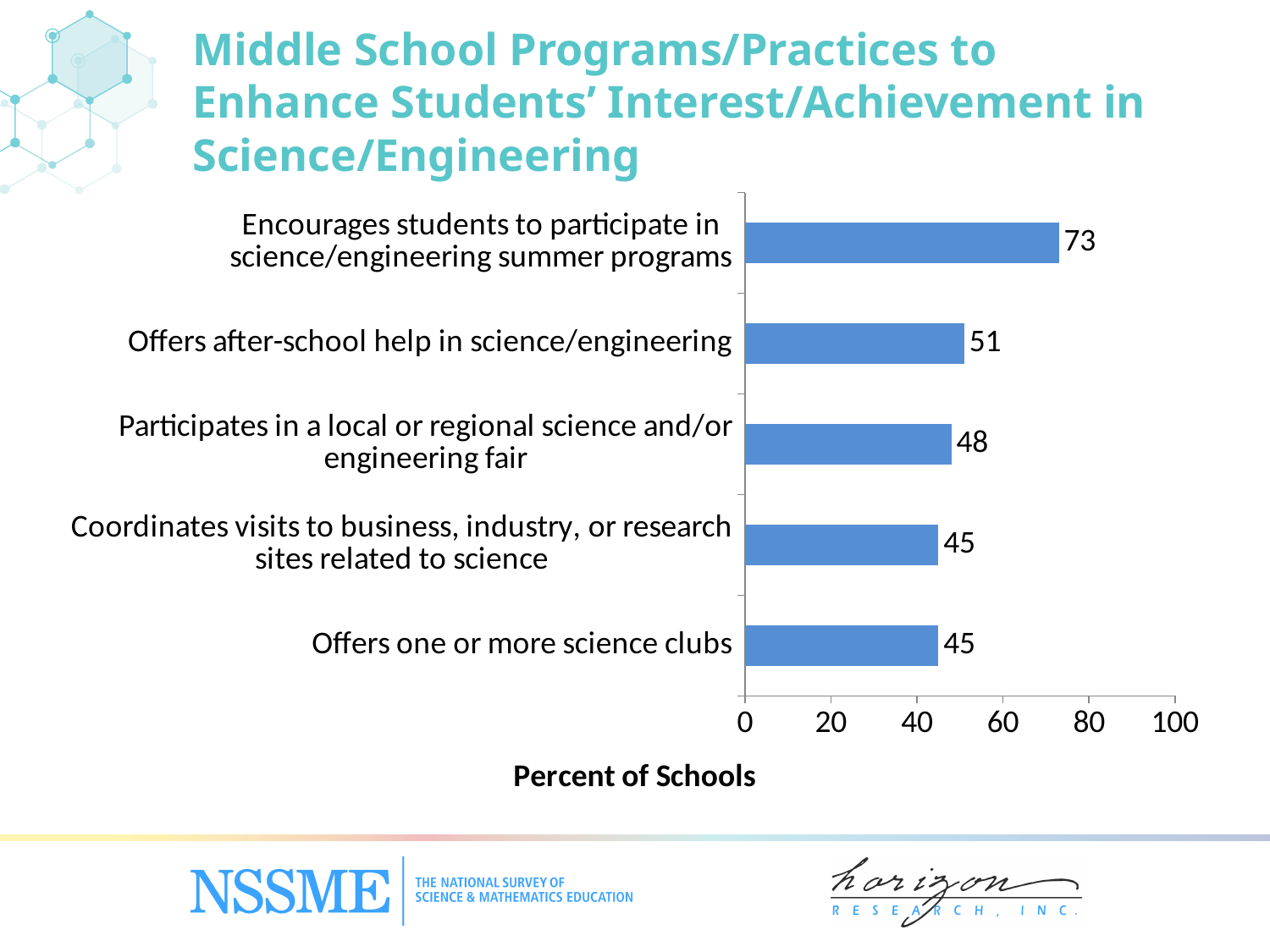
What percent of schools offer after-school help in science/engineering? 51 Which program/practice has the highest percent of schools? Encourages students to participate in science/engineering summer programs What percent of schools coordinate visits to business, industry, or research sites related to science? 45 Which has a higher percent of schools: offering after-school help in science/engineering or participating in a local or regional science and/or engineering fair? Offers after-school help in science/engineering Is the value for offering one or more science clubs greater or less than 60? less What percent of schools encourage students to participate in science/engineering summer programs? 73 What is the difference in percent of schools between encouraging participation in summer programs and offering after-school help in science/engineering? 22 What is the label of the horizontal axis? Percent of Schools What percent of schools participate in a local or regional science and/or engineering fair? 48 How many programs/practices are shown in the chart? 5 What kind of chart is shown on the slide? Bar chart What is the difference in percent of schools between participating in a science and/or engineering fair and offering one or more science clubs? 3